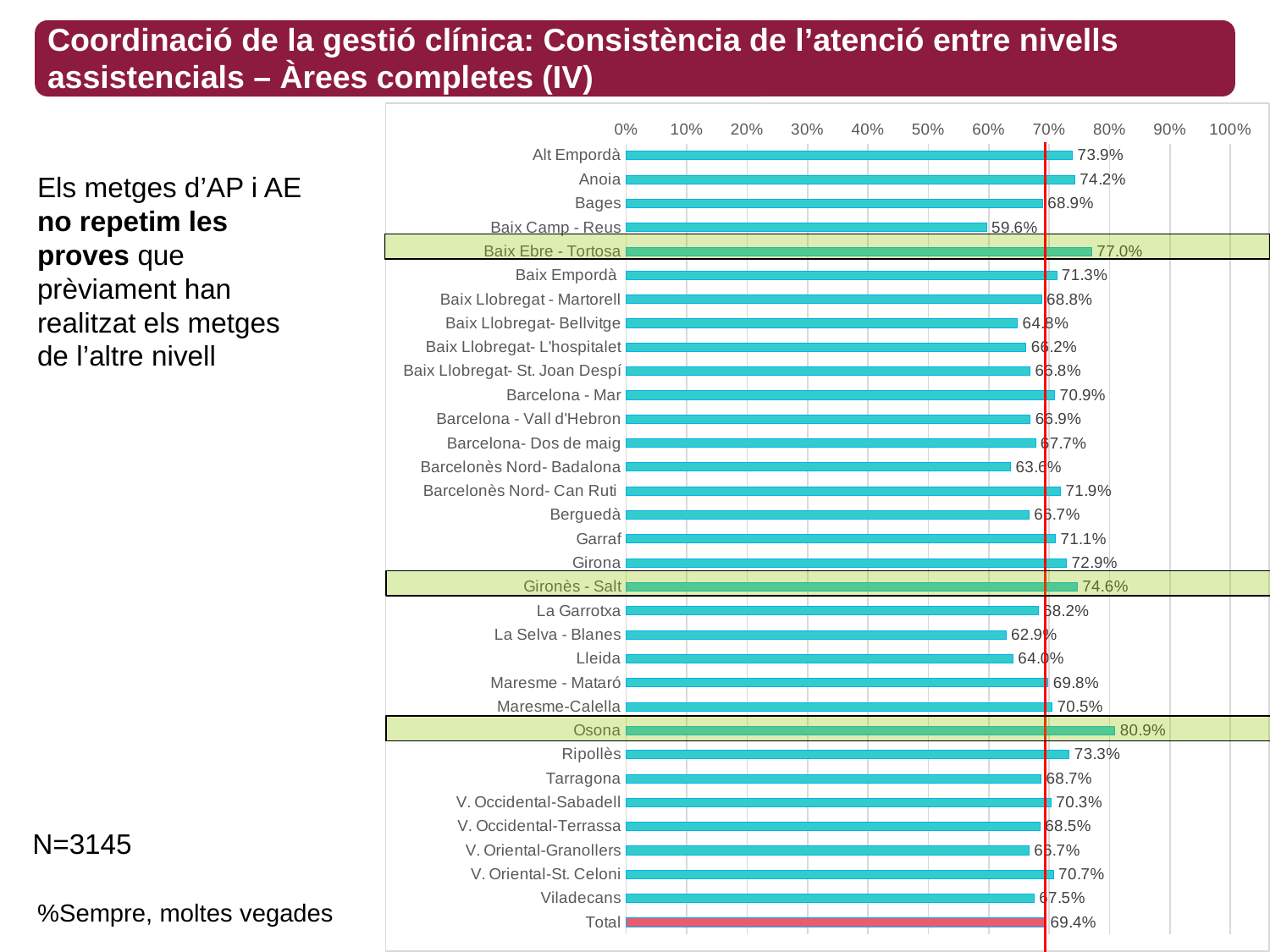
Is the value for Lleida greater or less than 70%? less Which is larger, the value for Anoia or the value for Alt Empordà? Anoia What is the value for Baix Ebre - Tortosa? 77.0% What is the difference between the value for Osona and the Total value? 11.5 percentage points What kind of chart is shown on the slide? Bar chart What is the value for the Total bar? 69.4% How many bars are plotted in the chart, including Total? 33 What is the difference between the values for Baix Ebre - Tortosa and Baix Camp - Reus? 17.4 percentage points Which area has the highest value? Osona What is the value for Gironès - Salt? 74.6% Which area has the lowest value? Baix Camp - Reus What is the value for Osona? 80.9%